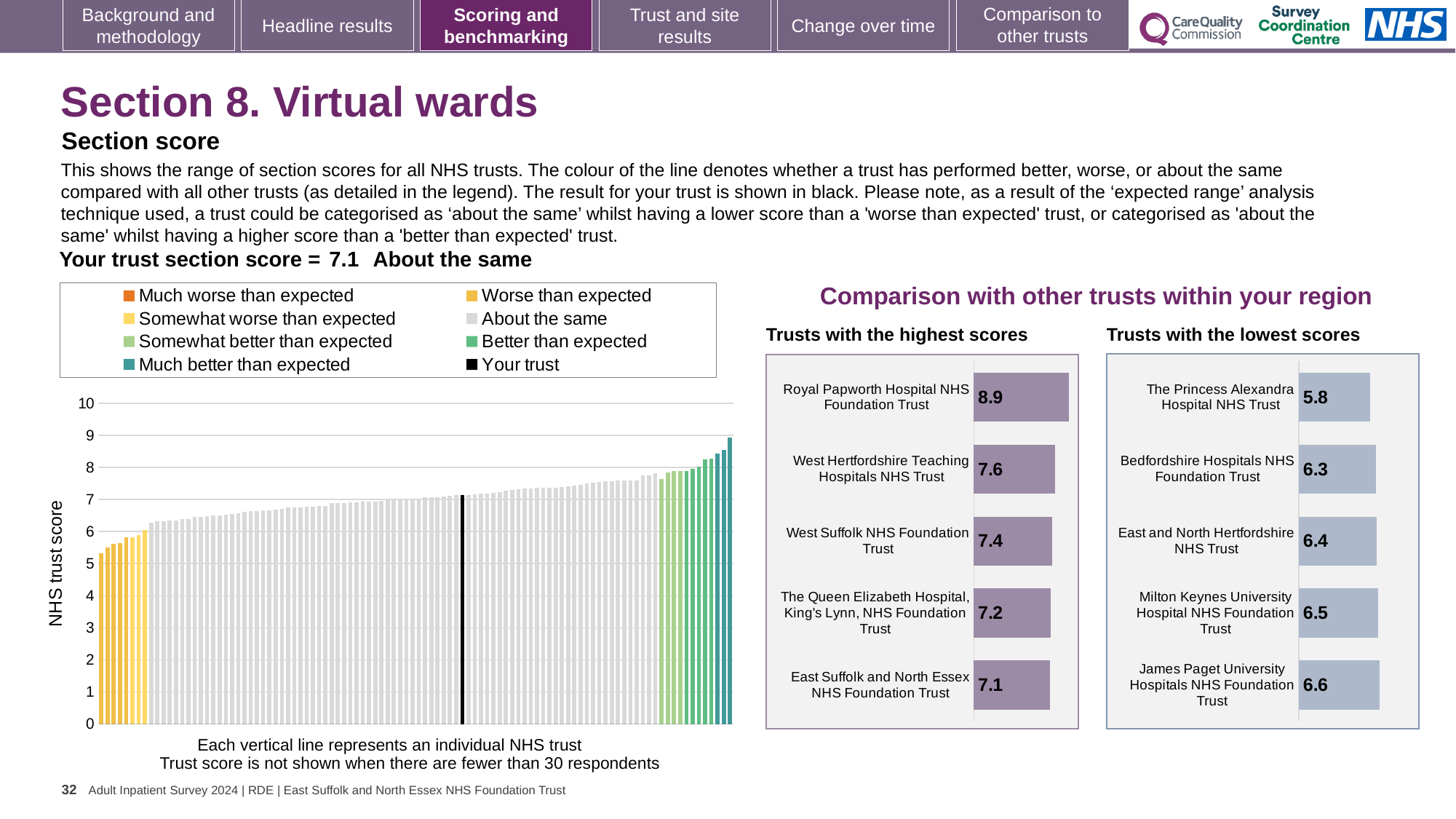
What kind of chart is the 'Trusts with the lowest scores' chart? bar chart In the 'Trusts with the highest scores' chart, what is the score for Royal Papworth Hospital NHS Foundation Trust? 8.9 In the 'Trusts with the lowest scores' chart, which has the larger score: Bedfordshire Hospitals NHS Foundation Trust or Milton Keynes University Hospital NHS Foundation Trust? Milton Keynes University Hospital NHS Foundation Trust In the 'Trusts with the highest scores' chart, which trust has the lowest score shown? East Suffolk and North Essex NHS Foundation Trust In the main NHS trust score chart on the left, what is the section score for your trust (the black bar)? 7.1 In the 'Trusts with the highest scores' chart, what is the difference between the scores of Royal Papworth Hospital NHS Foundation Trust and West Hertfordshire Teaching Hospitals NHS Trust? 1.3 In the 'Trusts with the lowest scores' chart, which trust has the highest score shown? James Paget University Hospitals NHS Foundation Trust How many entries does the legend of the main NHS trust score chart list? 8 How many trusts are listed in the 'Trusts with the highest scores' chart? 5 In the 'Trusts with the lowest scores' chart, what is the score for The Princess Alexandra Hospital NHS Trust? 5.8 In the main NHS trust score chart on the left, do the bar values rise or fall from left to right? rise In the main NHS trust score chart on the left, is the value of the tallest bar greater or less than 8? greater